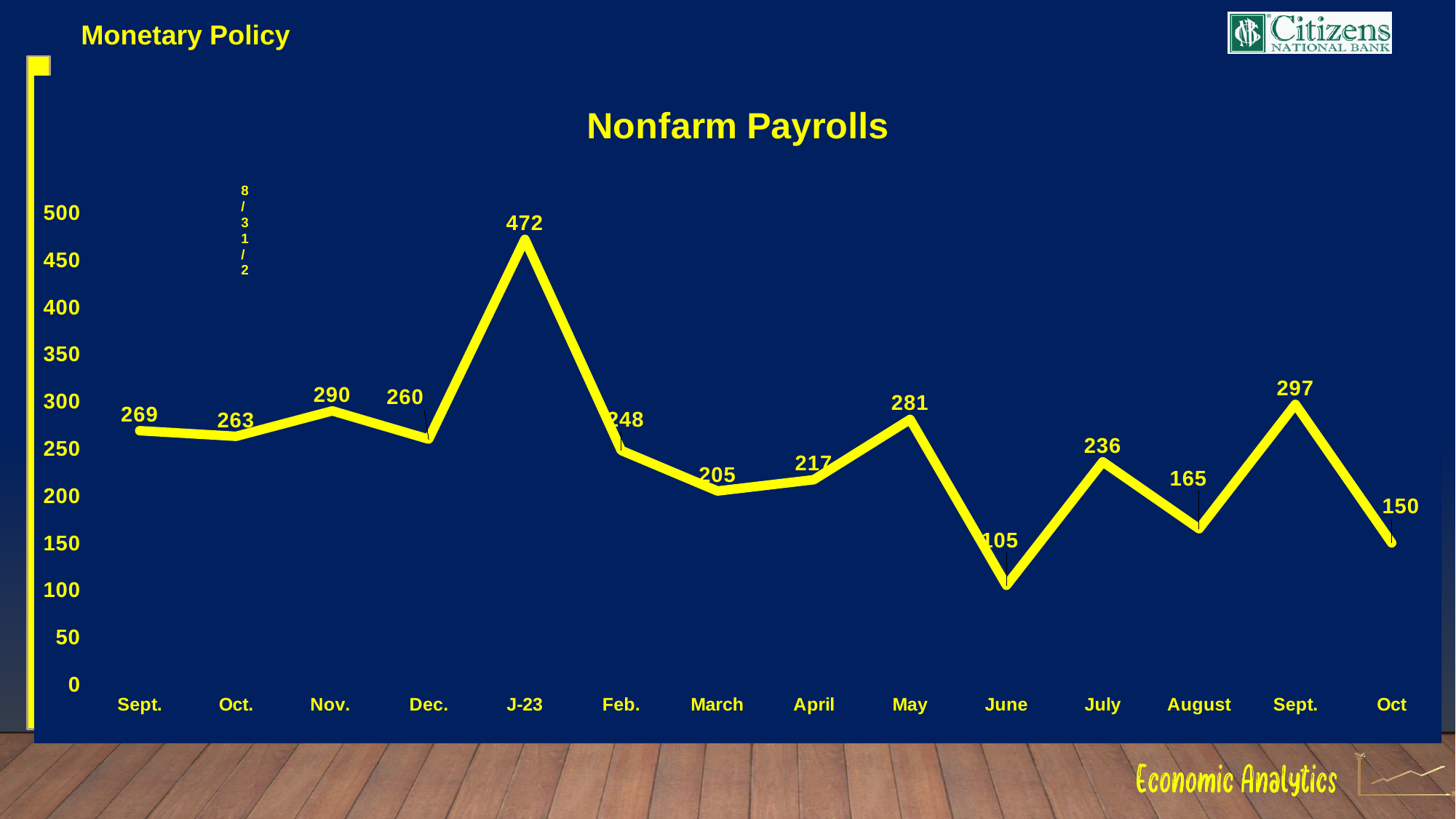
Which month has the lowest nonfarm payrolls value? June How many data points are plotted on the chart? 14 What is the title of the chart? Nonfarm Payrolls Which is larger, the value for July or the value for April? July What is the value for the last point on the chart, Oct? 150 What is the nonfarm payrolls value for August? 165 What is the nonfarm payrolls value for May? 281 What is the nonfarm payrolls value for March? 205 What kind of chart is shown on the slide? line chart Does the line rise or fall from May to June? fall Which month has the highest nonfarm payrolls value? J-23 What is the difference between the J-23 value and the Feb. value? 224